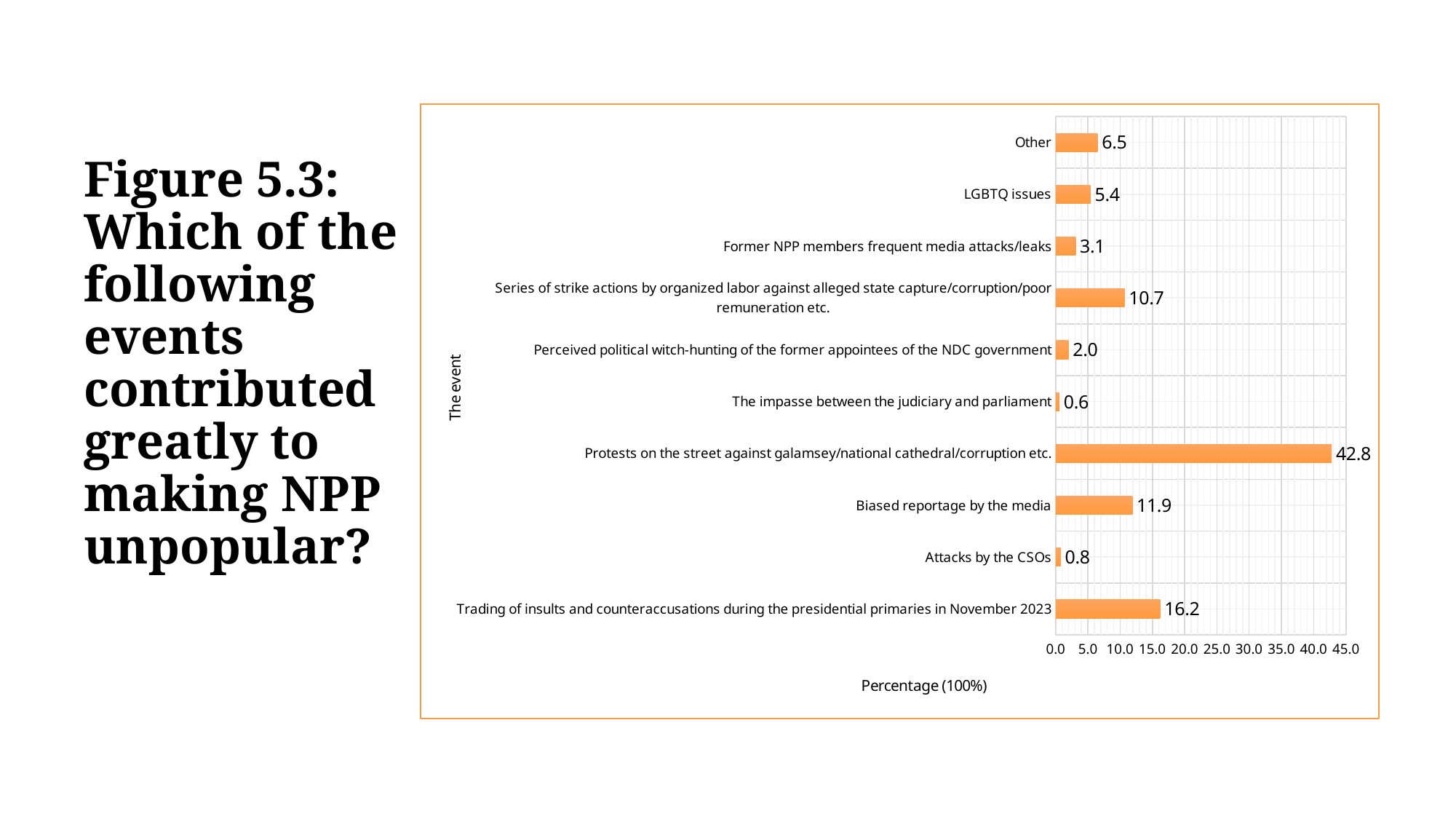
Which event has the lowest value? The impasse between the judiciary and parliament What is the value for "Trading of insults and counteraccusations during the presidential primaries in November 2023"? 16.2 What kind of chart is shown on the slide? Bar chart How many events are shown in the chart? 10 What is the value for "LGBTQ issues"? 5.4 What is the difference between the values for "Protests on the street against galamsey/national cathedral/corruption etc." and "Trading of insults and counteraccusations during the presidential primaries in November 2023"? 26.6 Which event has the highest value? Protests on the street against galamsey/national cathedral/corruption etc. What is the value for "Biased reportage by the media"? 11.9 What is the label of the horizontal axis? Percentage (100%) Which is larger: the value for "Series of strike actions by organized labor against alleged state capture/corruption/poor remuneration etc." or the value for "Other"? Series of strike actions by organized labor against alleged state capture/corruption/poor remuneration etc. What is the label of the vertical axis? The event Is the value for "Protests on the street against galamsey/national cathedral/corruption etc." greater or less than 40.0? greater